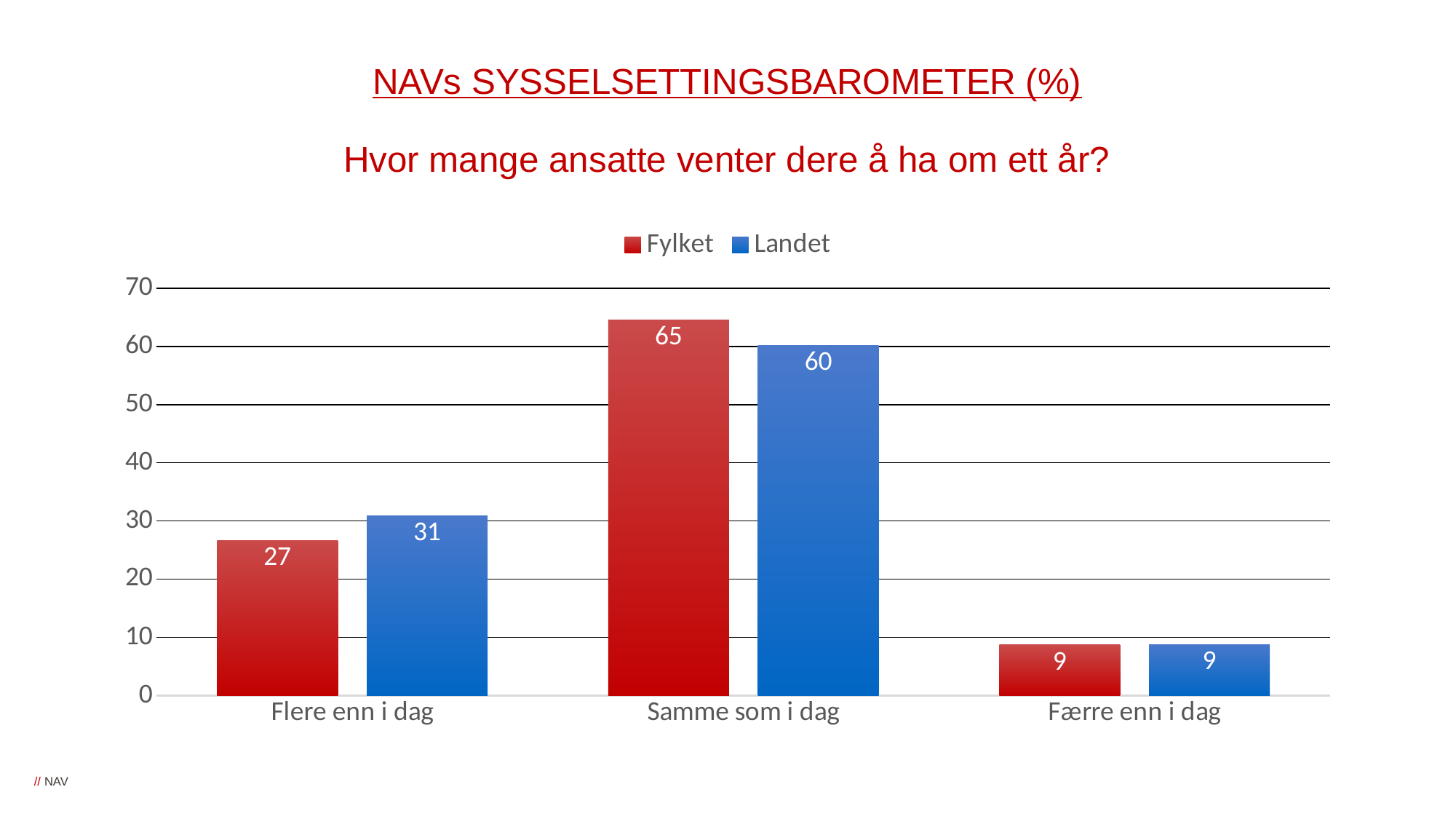
What is the value for Fylket in the "Færre enn i dag" category? 9 Which colour represents the Landet series in the legend? Blue What is the difference between Fylket and Landet in the "Samme som i dag" category? 5 How many categories are shown on the x axis? 3 In the "Flere enn i dag" category, which series has the larger value, Fylket or Landet? Landet What is the value for Fylket in the "Samme som i dag" category? 65 Which category has the highest value for Landet? Samme som i dag What is the difference between the Fylket values for "Samme som i dag" and "Flere enn i dag"? 38 Which category has the lowest value for Fylket? Færre enn i dag How many series does the legend list? 2 What kind of chart is shown on the slide? Bar chart What is the value for Landet in the "Flere enn i dag" category? 31